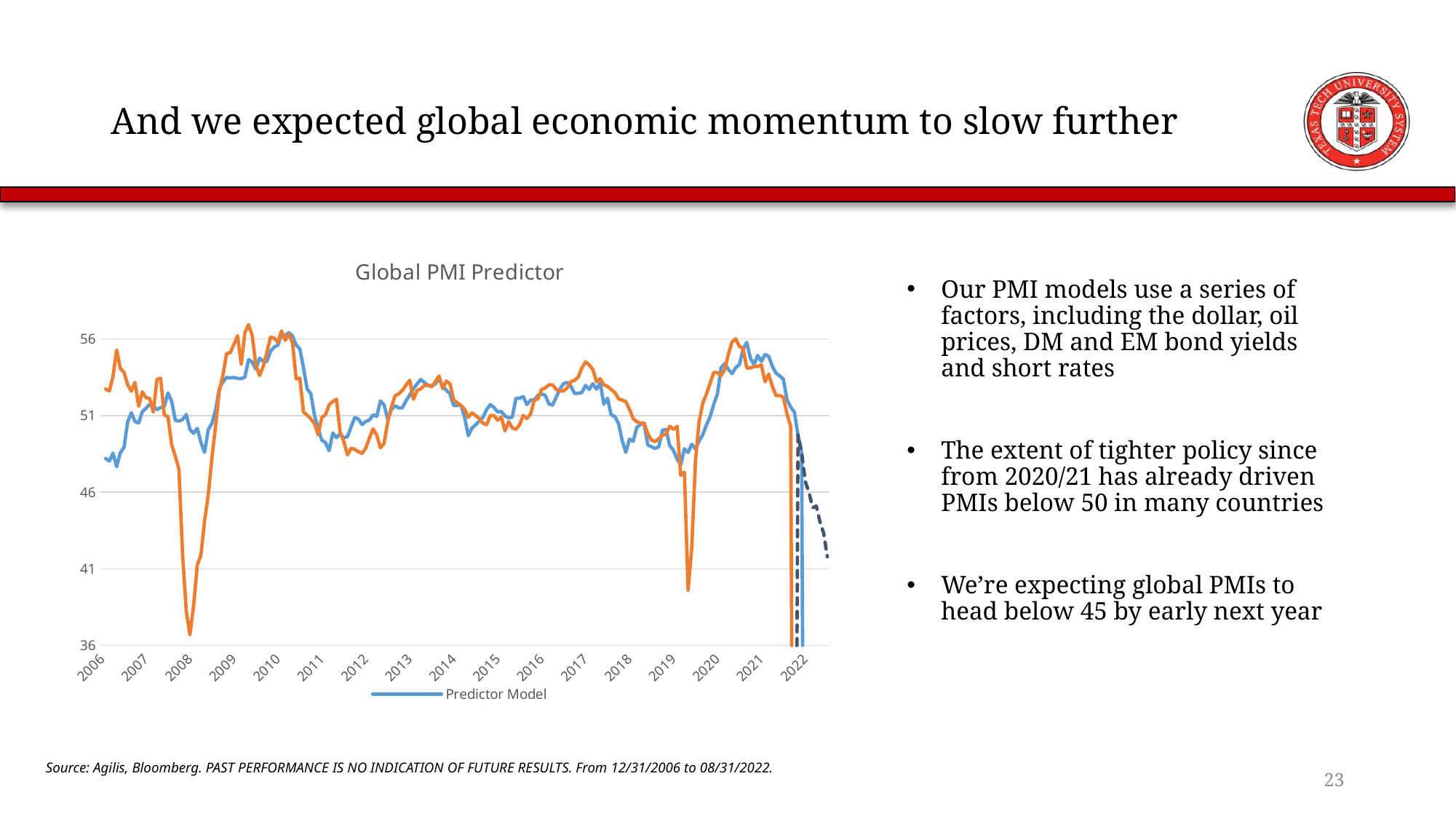
What is the name of the series listed in the chart's legend? Predictor Model In early 2008, which line is lower, the orange line or the blue Predictor Model line? the orange line What is the lowest value shown on the y axis of the chart? 36 Is the sharp dip of the orange line around 2020 greater or less than 41? less What is the title of the chart? Global PMI Predictor How many year labels are shown on the x axis of the chart? 17 What is the highest value shown on the y axis of the chart? 56 Is the lowest point of the orange line in 2008 greater or less than 41? less What kind of chart is shown on the slide? line chart How many series does the chart's legend list? 1 Is the peak of the orange line around 2009-2010 greater or less than 56? greater Does the dashed projection line at the right end of the chart rise or fall? fall